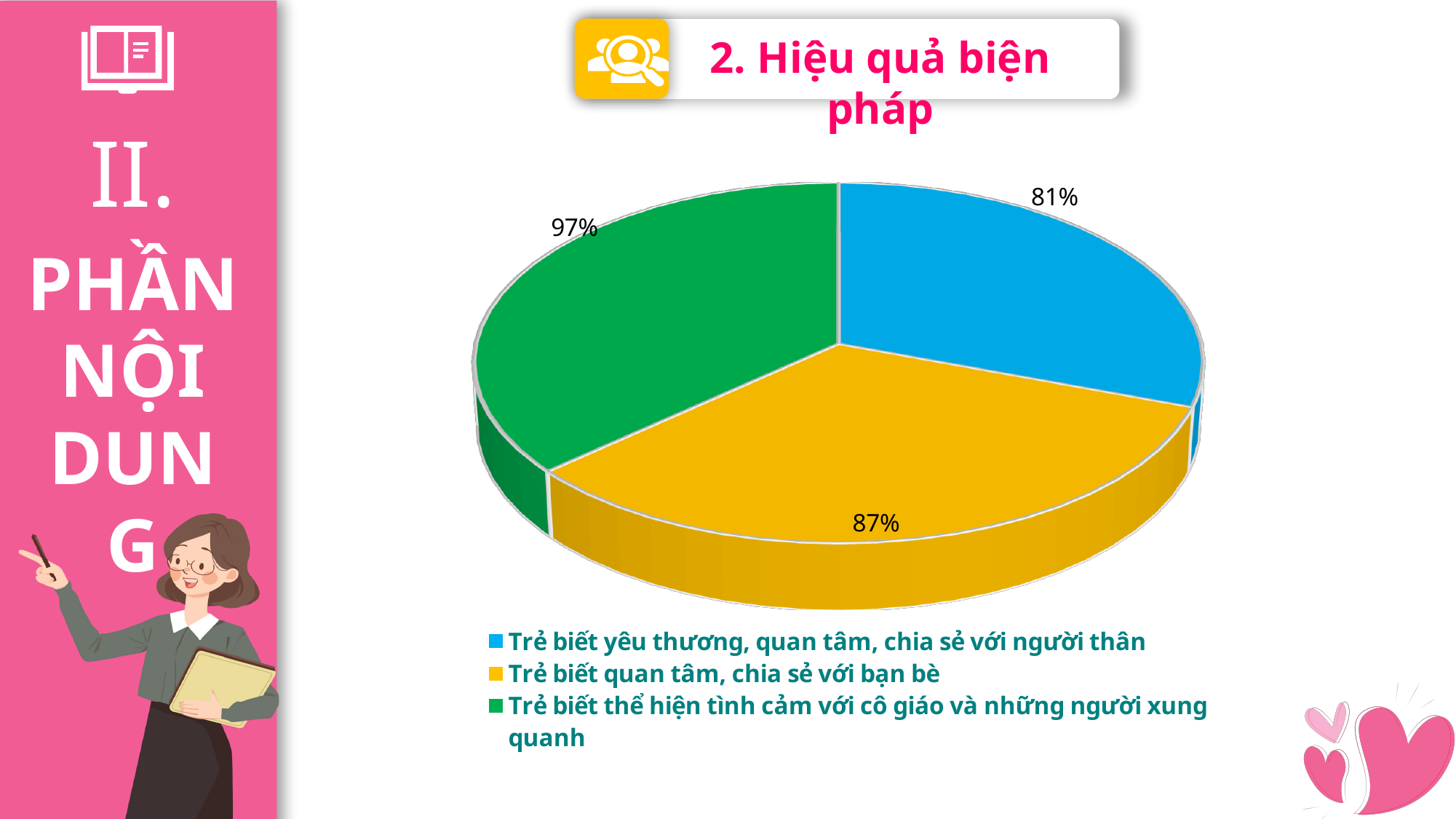
What value is labelled on the slice for "Trẻ biết yêu thương, quan tâm, chia sẻ với người thân"? 81% Which category has the highest labelled value in the pie chart? Trẻ biết thể hiện tình cảm với cô giáo và những người xung quanh What value is labelled on the slice for "Trẻ biết quan tâm, chia sẻ với bạn bè"? 87% What value is labelled on the slice for "Trẻ biết thể hiện tình cảm với cô giáo và những người xung quanh"? 97% What kind of chart is shown on the slide? Pie chart What is the difference between the labelled values for "Trẻ biết quan tâm, chia sẻ với bạn bè" and "Trẻ biết yêu thương, quan tâm, chia sẻ với người thân"? 6% Which category has the lowest labelled value in the pie chart? Trẻ biết yêu thương, quan tâm, chia sẻ với người thân What is the difference between the labelled values for "Trẻ biết thể hiện tình cảm với cô giáo và những người xung quanh" and "Trẻ biết yêu thương, quan tâm, chia sẻ với người thân"? 16% What colour is the slice for "Trẻ biết quan tâm, chia sẻ với bạn bè"? Yellow What is the title shown above the chart? 2. Hiệu quả biện pháp How many slices does the pie chart have? 3 Which has the larger labelled value: "Trẻ biết quan tâm, chia sẻ với bạn bè" or "Trẻ biết yêu thương, quan tâm, chia sẻ với người thân"? Trẻ biết quan tâm, chia sẻ với bạn bè